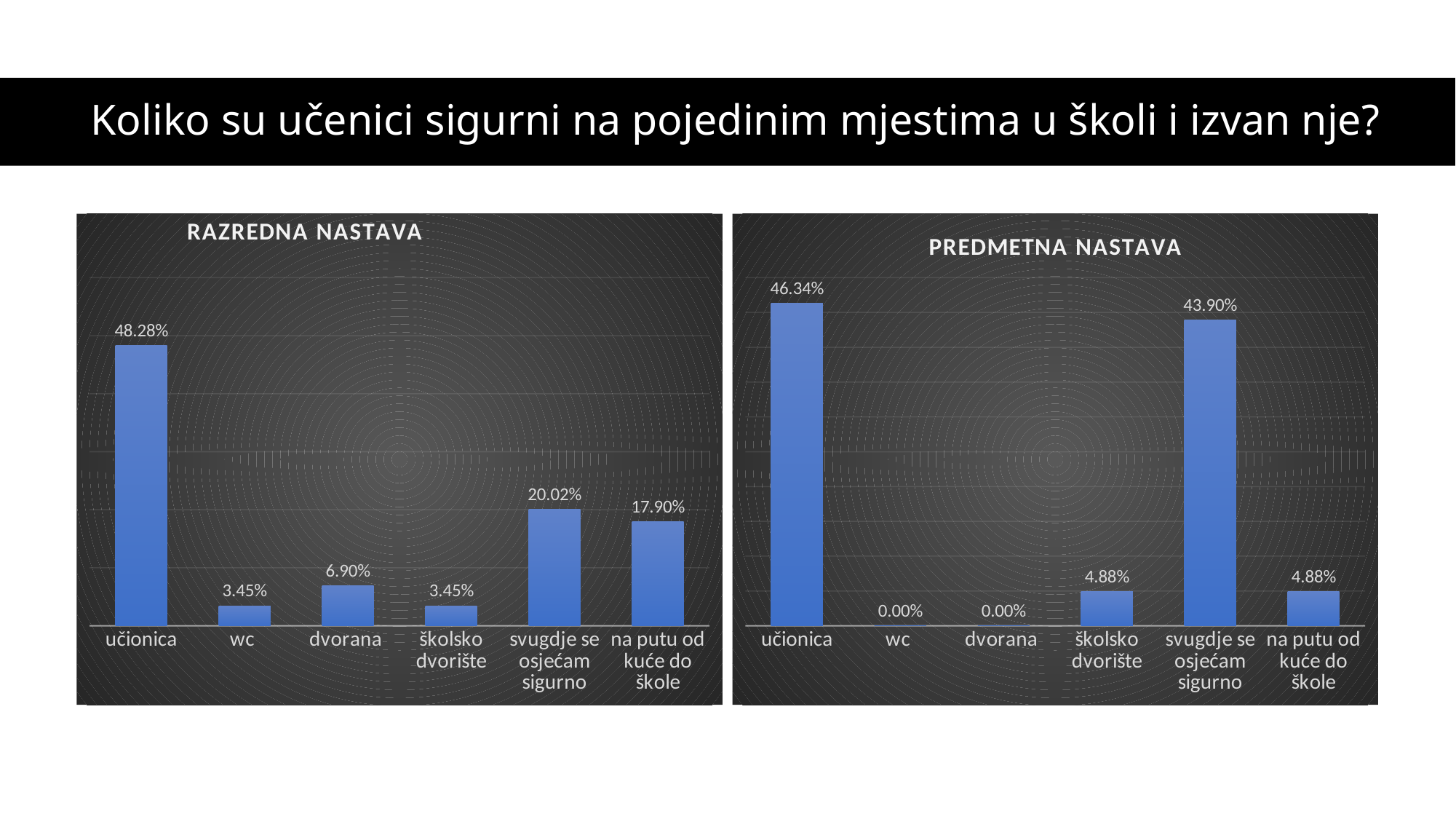
How many categories are shown in the PREDMETNA NASTAVA chart? 6 What type of chart is the RAZREDNA NASTAVA chart? bar chart In the PREDMETNA NASTAVA chart, which category has the highest value? učionica In the PREDMETNA NASTAVA chart, what is the value for svugdje se osjećam sigurno? 43.90% In the RAZREDNA NASTAVA chart, which is larger, dvorana or wc? dvorana In the RAZREDNA NASTAVA chart, what is the value for učionica? 48.28% What is the title of the chart on the right side of the slide? PREDMETNA NASTAVA In the RAZREDNA NASTAVA chart, what is the value for na putu od kuće do škole? 17.90% In the PREDMETNA NASTAVA chart, what is the value for wc? 0.00% In the PREDMETNA NASTAVA chart, what is the difference between učionica and svugdje se osjećam sigurno? 2.44% In the RAZREDNA NASTAVA chart, which category has the highest value? učionica In the RAZREDNA NASTAVA chart, what is the difference between svugdje se osjećam sigurno and na putu od kuće do škole? 2.12%